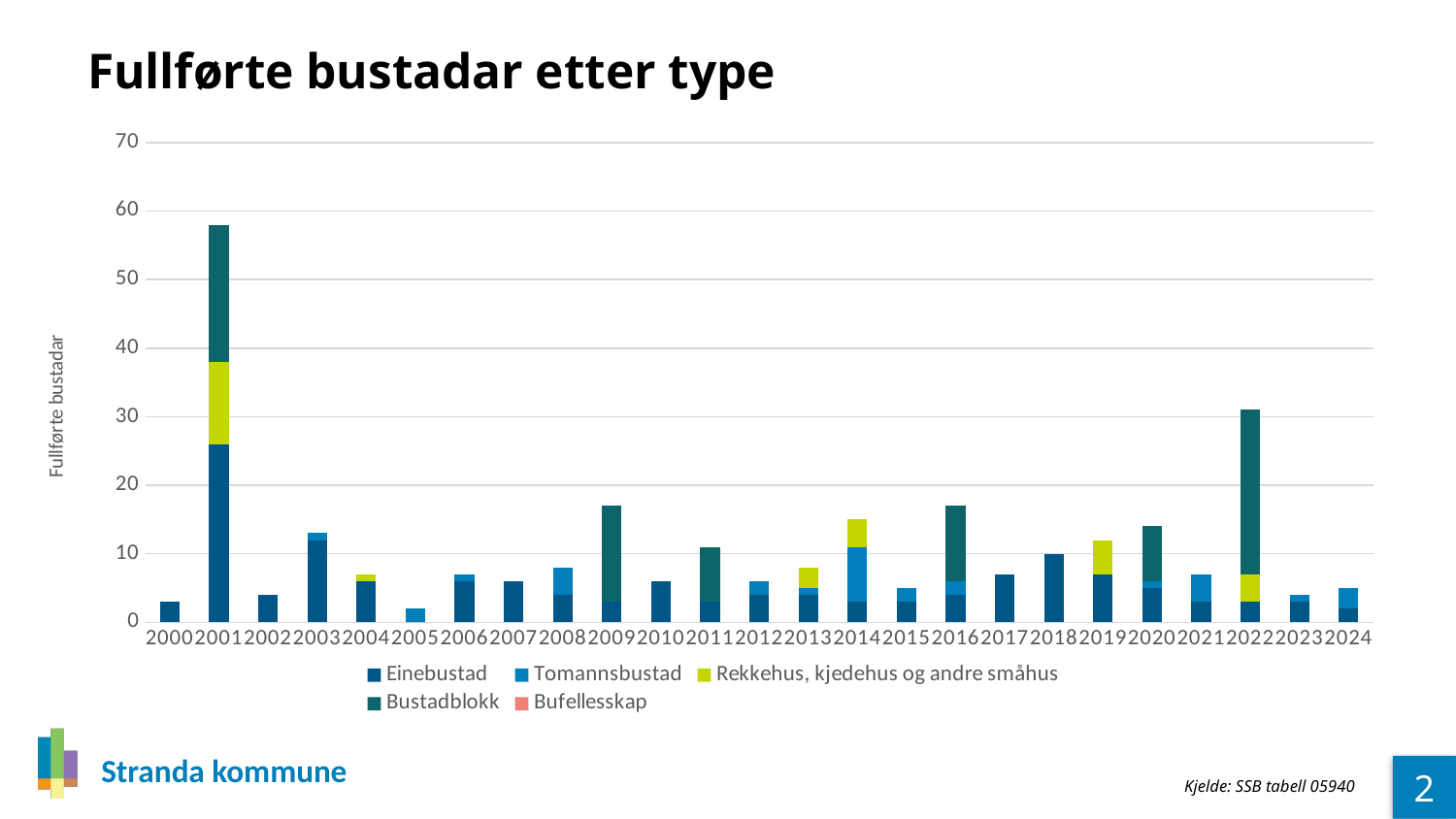
Which year has the larger total, 2001 or 2022? 2001 Is the total value for 2001 greater or less than 50? greater Is the total value for 2005 greater or less than 10? less How many series does the legend list? 5 What is the title of the chart? Fullførte bustadar etter type How many years are shown along the x axis? 25 Which year has the larger total, 2009 or 2010? 2009 Is the total value for 2009 greater or less than 10? greater What kind of chart is shown on the slide? Stacked bar chart What is the label of the y axis? Fullførte bustadar Which year has the highest total of completed dwellings? 2001